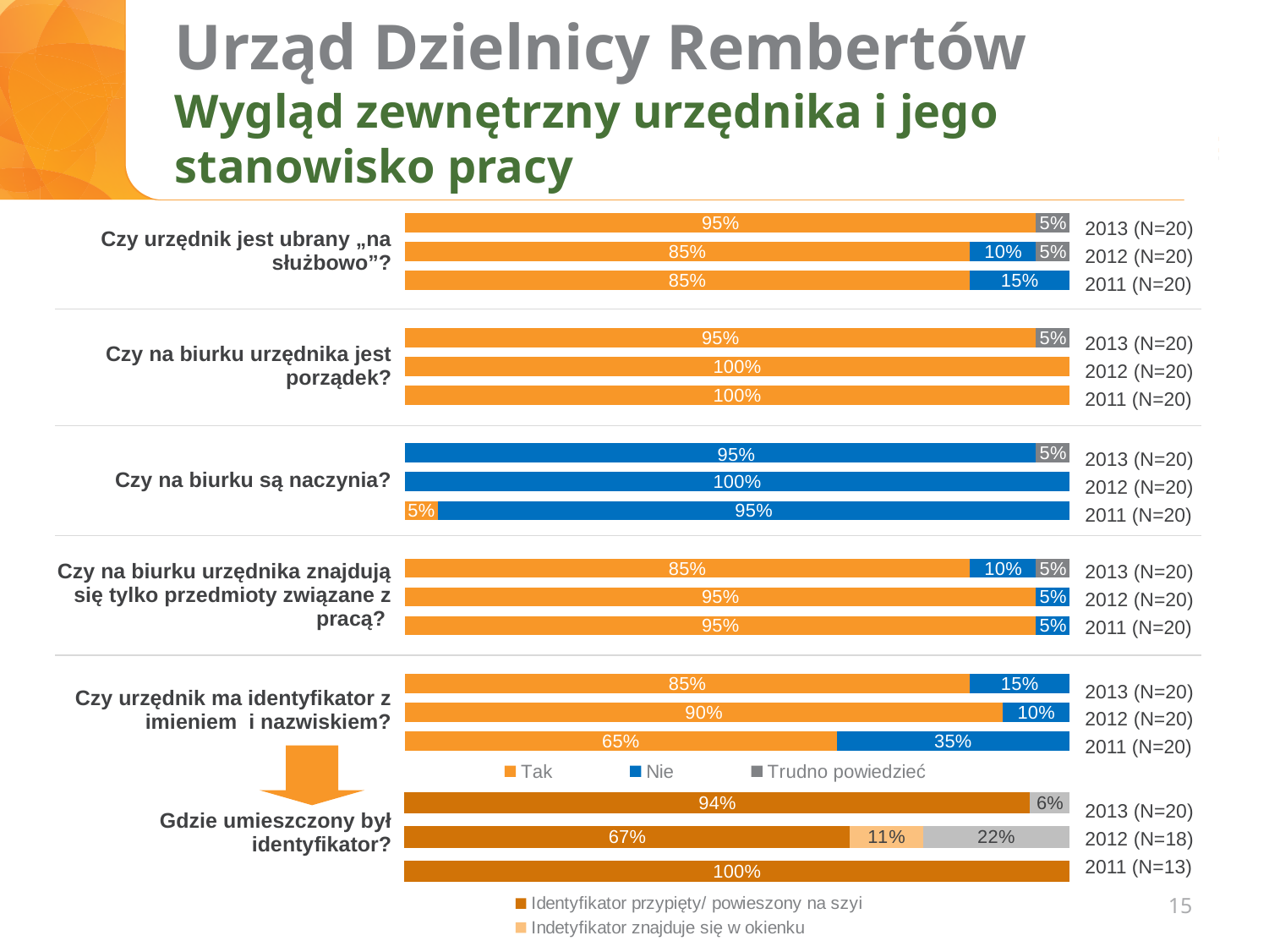
In the chart "Czy urzędnik ma identyfikator z imieniem i nazwiskiem?", is the Tak share larger in 2013 or in 2012? 2012 In the chart "Gdzie umieszczony był identyfikator?", what is the sample size for 2011? N=13 In the chart "Czy na biurku są naczynia?", what is the Tak share for 2011 (N=20)? 5% In the chart "Czy urzędnik jest ubrany „na służbowo”?", what percentage answered Tak in 2013 (N=20)? 95% In the chart "Czy urzędnik ma identyfikator z imieniem i nazwiskiem?", what is the difference between the Tak share in 2012 and in 2011? 25 percentage points In the chart "Czy na biurku urzędnika znajdują się tylko przedmioty związane z pracą?", what is the Nie share for 2013 (N=20)? 10% In the chart "Czy urzędnik jest ubrany „na służbowo”?", what is the Nie share for 2011 (N=20)? 15% In the chart "Gdzie umieszczony był identyfikator?", what is the share for "Identyfikator przypięty/ powieszony na szyi" in 2012 (N=18)? 67% In the chart "Czy na biurku urzędnika jest porządek?", which year has the lowest Tak share? 2013 (N=20) How many series does the legend with Tak, Nie and Trudno powiedzieć list? 3 In the chart "Czy na biurku są naczynia?", what colour is the 100% bar for 2012? Blue In the chart "Czy urzędnik ma identyfikator z imieniem i nazwiskiem?", which year has the highest Nie share? 2011 (N=20)